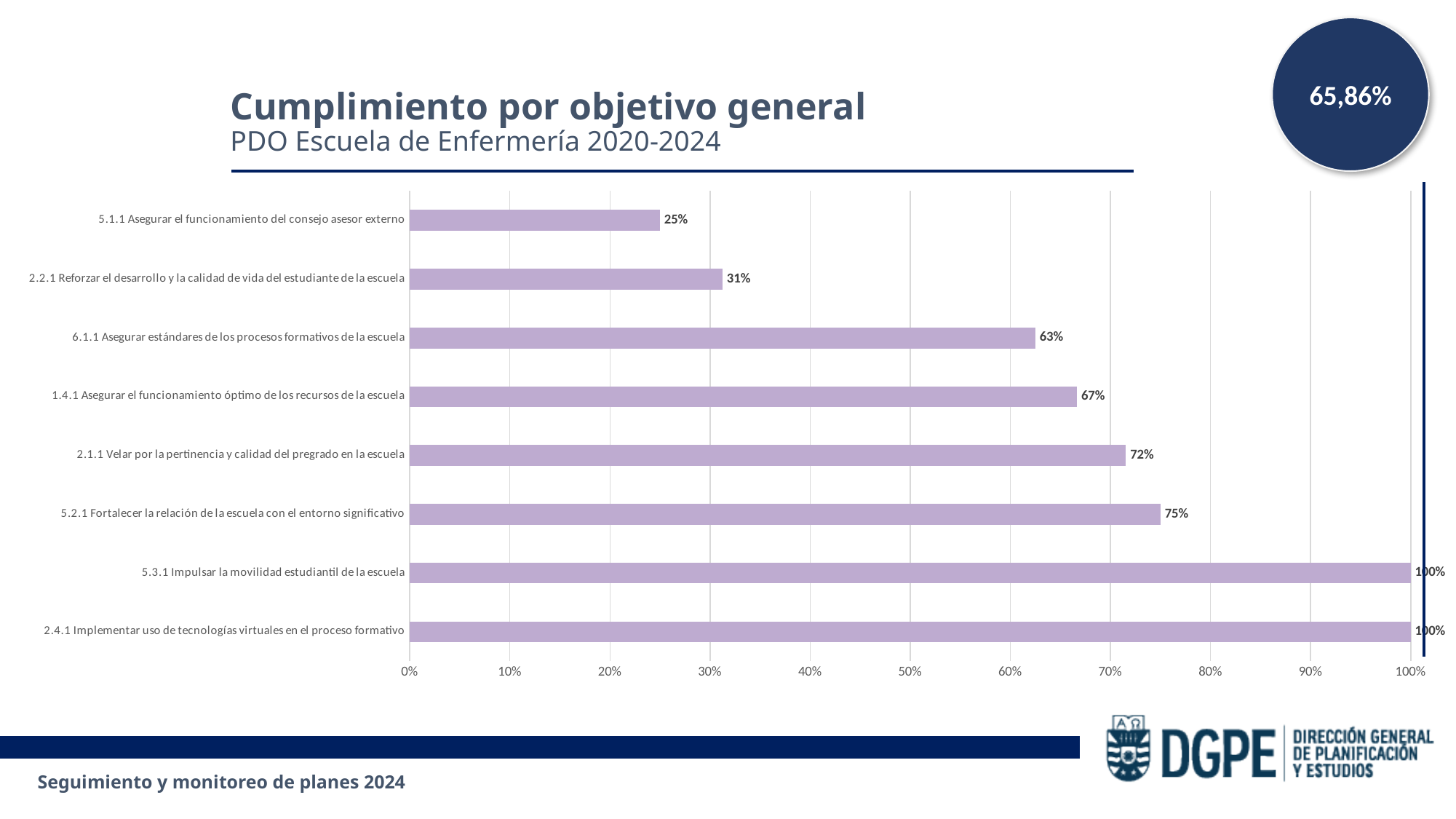
What is the value for 2.1.1 Velar por la pertinencia y calidad del pregrado en la escuela? 72% Which is larger: the value for 6.1.1 Asegurar estándares de los procesos formativos de la escuela or the value for 2.1.1 Velar por la pertinencia y calidad del pregrado en la escuela? 2.1.1 Velar por la pertinencia y calidad del pregrado en la escuela How many categories have a value of 100%? 2 Which category has the lowest value? 5.1.1 Asegurar el funcionamiento del consejo asesor externo What is the value for 5.2.1 Fortalecer la relación de la escuela con el entorno significativo? 75% What kind of chart is shown on the slide? bar chart How many categories are shown in the chart? 8 What is the title of the chart? Cumplimiento por objetivo general What is the value for 6.1.1 Asegurar estándares de los procesos formativos de la escuela? 63% What is the value for 5.1.1 Asegurar el funcionamiento del consejo asesor externo? 25% Is the value for 2.2.1 Reforzar el desarrollo y la calidad de vida del estudiante de la escuela greater or less than 40%? less What is the difference between the values for 1.4.1 Asegurar el funcionamiento óptimo de los recursos de la escuela and 2.2.1 Reforzar el desarrollo y la calidad de vida del estudiante de la escuela? 36%